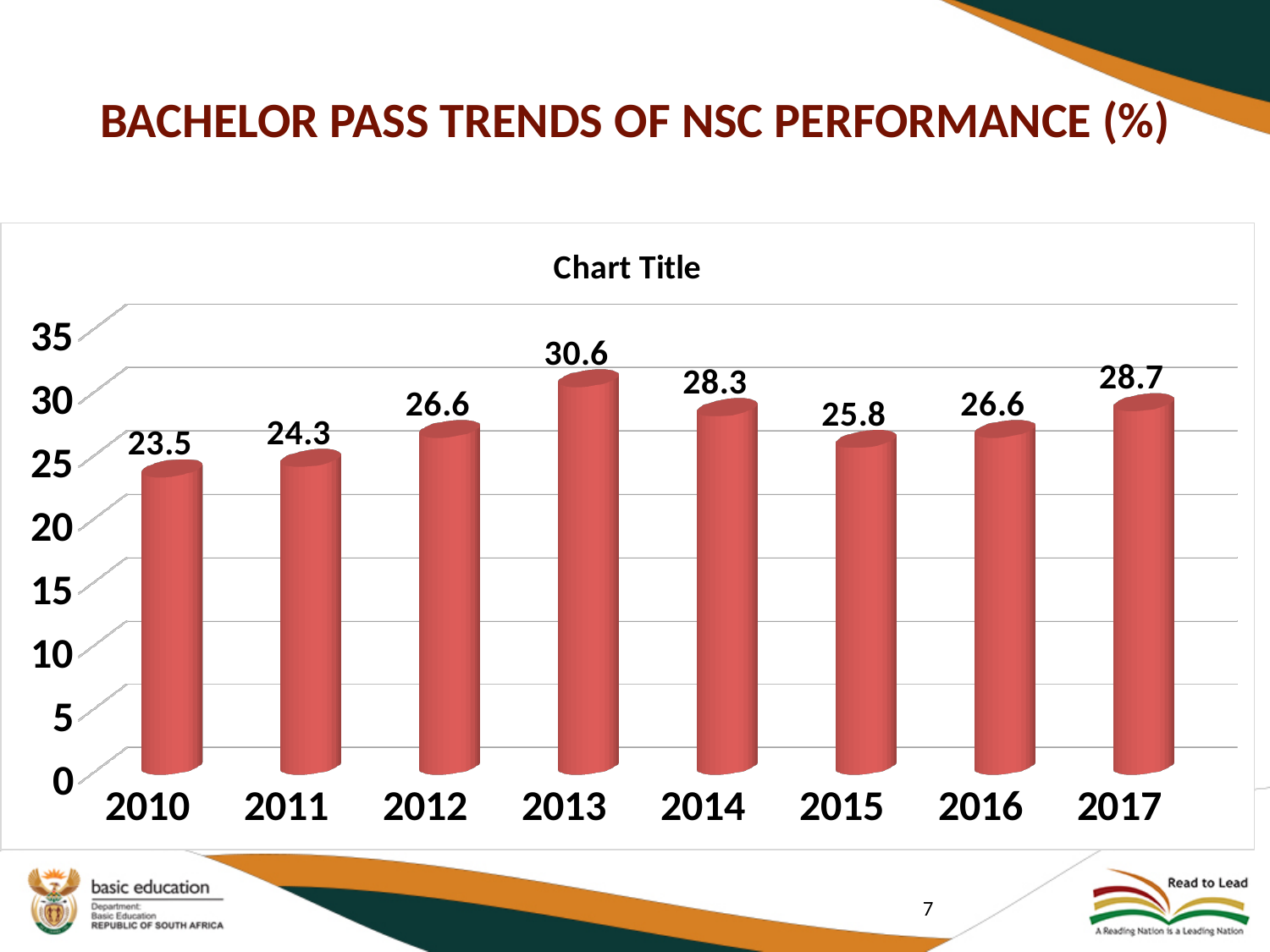
What is the difference between the values for 2013 and 2010? 7.1 What is the difference between the values for 2017 and 2016? 2.1 Which is larger, the value for 2014 or the value for 2015? 2014 What kind of chart is shown on the slide? bar chart What is the bachelor pass value for 2010? 23.5 Which year has the lowest bachelor pass value? 2010 Which year has the highest bachelor pass value? 2013 What is the bachelor pass value for 2015? 25.8 Do the values rise or fall from 2010 to 2013? rise Is the value for 2011 greater or less than 25? less How many years are shown on the chart? 8 What is the bachelor pass value for 2013? 30.6